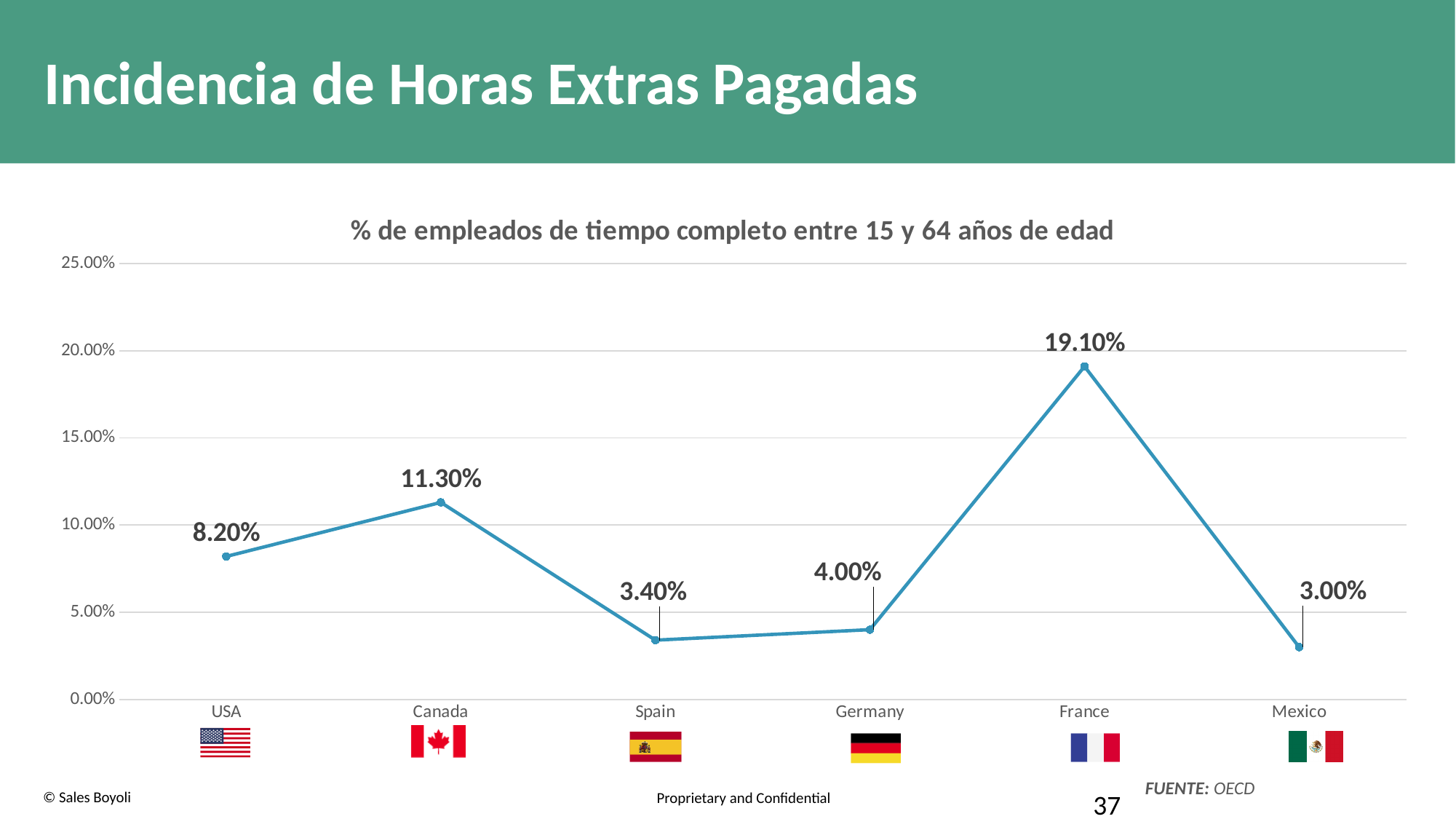
What is the value for France? 19.10% Is the value for Canada greater or less than 10.00%? greater What kind of chart is shown on the slide? Line chart Which has a larger value, Spain or Germany? Germany Which country has the lowest value? Mexico What is the value for Mexico? 3.00% Does the value rise or fall from Canada to Spain? Fall What is the title of the chart? % de empleados de tiempo completo entre 15 y 64 años de edad How many countries are plotted on the chart? 6 What is the value for Canada? 11.30% What is the difference between the values for France and USA? 10.90% Which country has the highest value? France